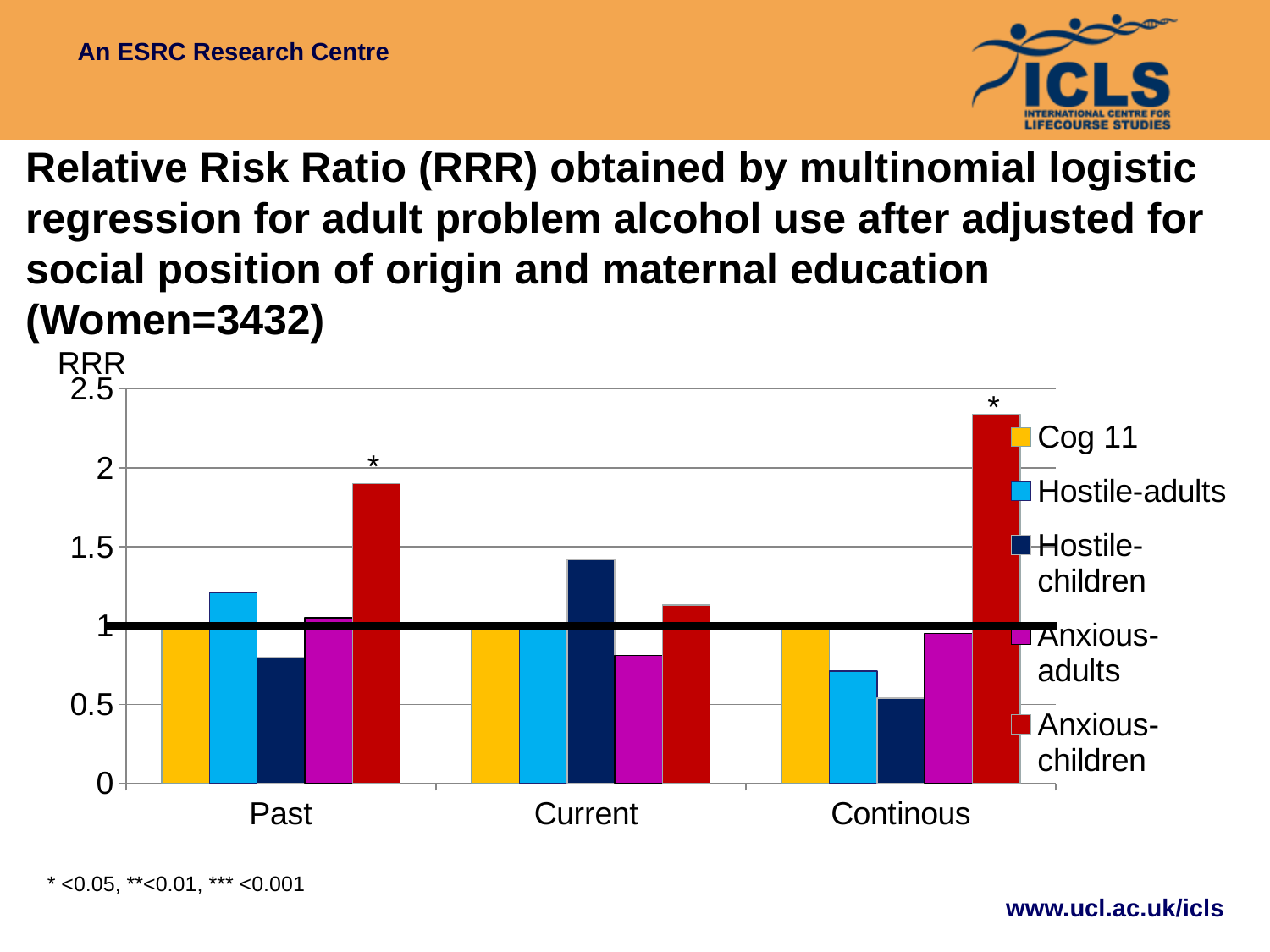
In the Current category, which is larger: Hostile-children or Anxious-adults? Hostile-children Which series has the tallest bar in the whole chart, and in which category? Anxious-children, Continous How many categories are shown on the x axis of the chart? 3 In the Past category, which is larger: Hostile-adults or Hostile-children? Hostile-adults Is the value for Hostile-children in the Continous category greater or less than 1? less Do the values for Hostile-adults rise or fall from Past to Current to Continous? fall In the Continous category, which series has the lowest bar? Hostile-children What kind of chart is shown on the slide? bar chart Is the value for Anxious-children in the Past category greater or less than 1.5? greater How many series does the chart's legend list? 5 What label is shown on the y axis of the chart? RRR Is the value for Anxious-children in the Continous category greater or less than 2? greater